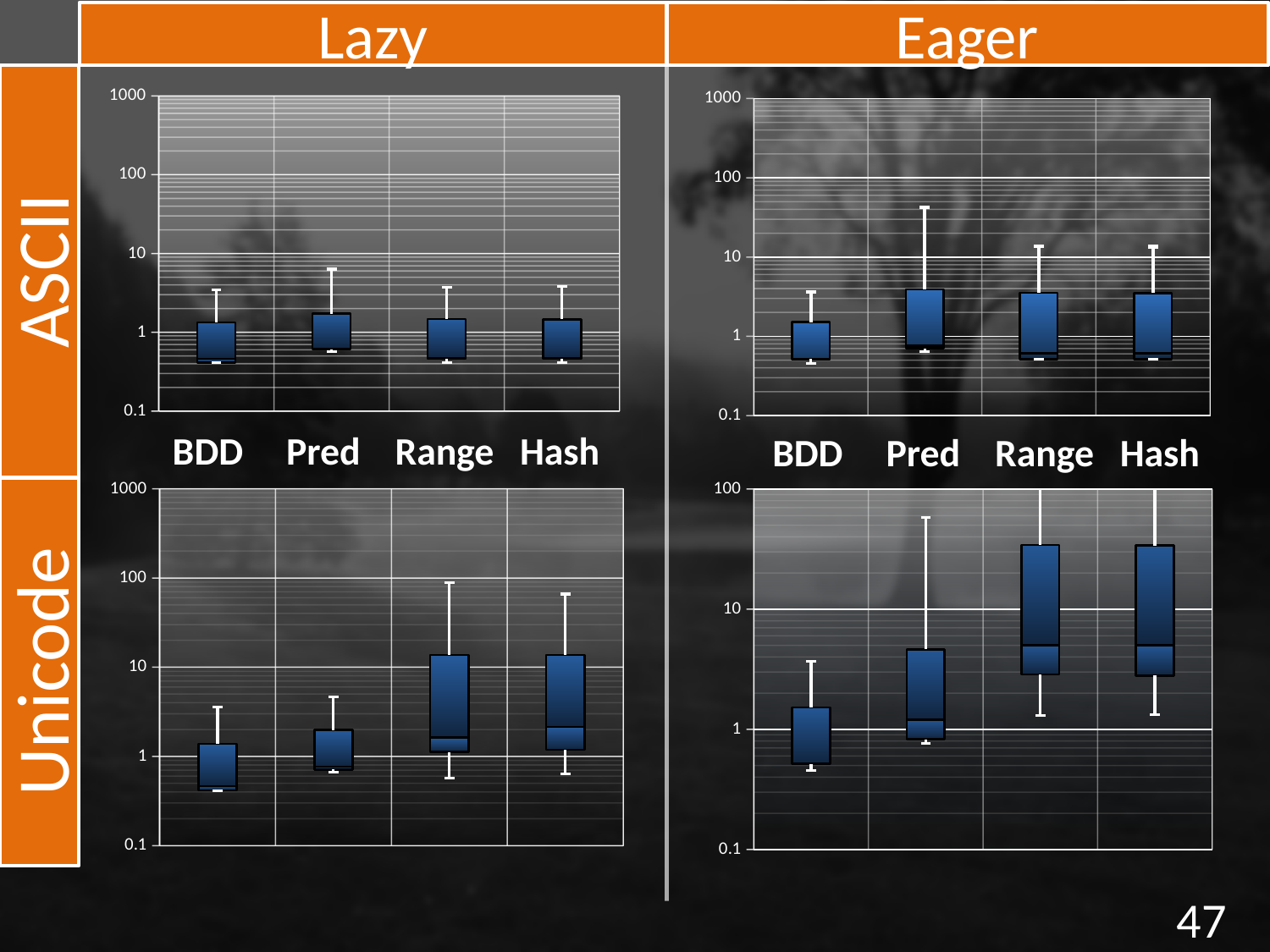
In the Eager ASCII chart (top right), is the top whisker for Pred greater or less than 10? greater What is the highest value shown on the y axis of the Eager Unicode chart (bottom right)? 100 What kind of chart is the Lazy ASCII chart (top left)? box plot In the Eager ASCII chart (top right), which category has the highest top whisker? Pred How many categories are shown on the x axis of the Eager Unicode chart (bottom right)? 4 In the Eager Unicode chart (bottom right), is the median for Range greater or less than 10? less In the Eager Unicode chart (bottom right), which has the larger median, BDD or Range? Range What are the two column headings above the charts? Lazy and Eager In the Lazy Unicode chart (bottom left), which category has the lowest median? BDD In the Eager Unicode chart (bottom right), is the top of the box for Range greater or less than 10? greater